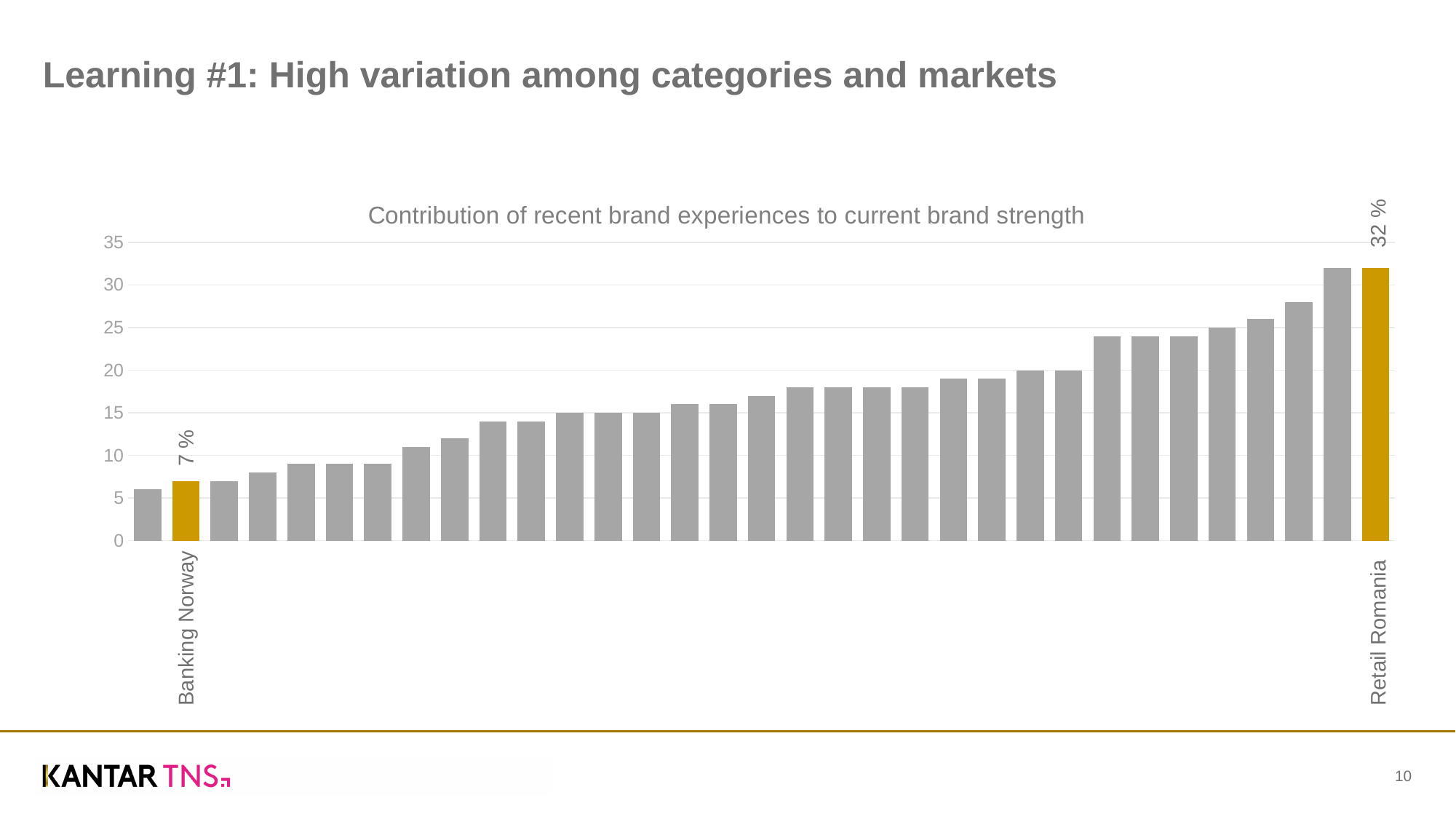
What colour are the highlighted bars for Banking Norway and Retail Romania? Gold What is the title of the chart? Contribution of recent brand experiences to current brand strength What is the value shown for Banking Norway? 7 % Which has the larger value, Banking Norway or Retail Romania? Retail Romania What is the value shown for Retail Romania? 32 % What is the difference between the values for Retail Romania and Banking Norway? 25 % Is the value for Retail Romania greater or less than 30? greater Is the value for Banking Norway greater or less than 10? less What kind of chart is shown on the slide? Bar chart Do the bar values rise or fall from left to right along the x axis? Rise